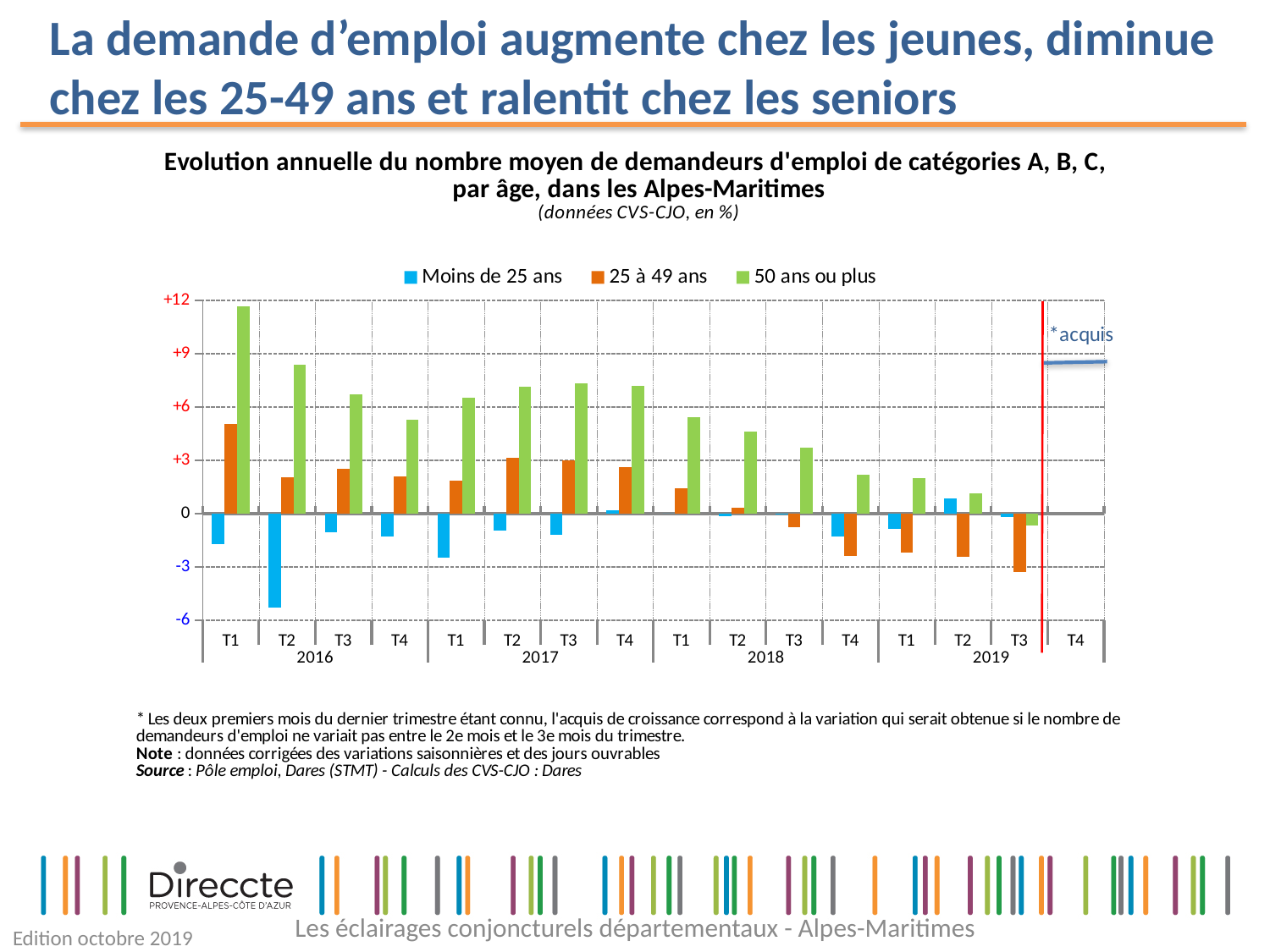
Is the value for '25 à 49 ans' in T1 2016 greater or less than +3? greater Is the value for 'Moins de 25 ans' in T2 2016 greater or less than -3? less In which quarter is the value for '50 ans ou plus' the highest? T1 2016 Do the values for '50 ans ou plus' rise or fall from T1 2018 to T3 2019? fall How many quarters are labelled along the x axis? 16 How many series does the legend list? 3 What are the three series listed in the legend? Moins de 25 ans, 25 à 49 ans, 50 ans ou plus Is the value for '50 ans ou plus' in T1 2016 greater or less than +9? greater In which quarter is the value for 'Moins de 25 ans' the lowest? T2 2016 In which quarter is the value for '25 à 49 ans' the lowest? T3 2019 What kind of chart is shown on the slide? bar chart In T1 2016, which is larger: the value for '25 à 49 ans' or for '50 ans ou plus'? 50 ans ou plus